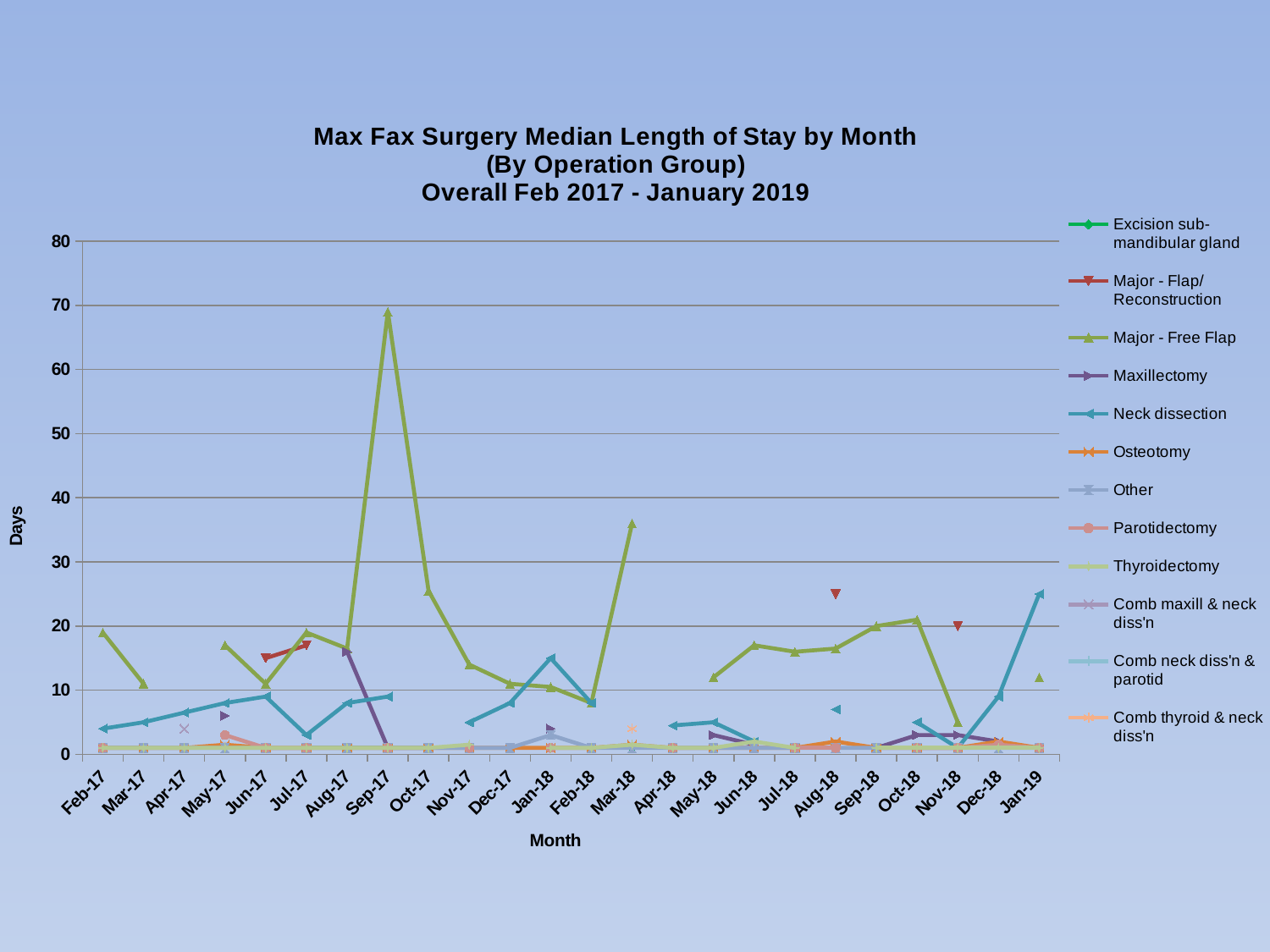
What kind of chart is shown on the slide? line chart What is the label of the x axis? Month Which is larger for Major - Free Flap: the value in Sep-17 or the value in Oct-17? Sep-17 Is the value for Neck dissection in Jul-17 greater or less than 10? less How many months are shown along the x axis? 24 Is the value for Major - Free Flap in Mar-18 greater or less than 30? greater Is the value for Major - Free Flap in Sep-17 greater or less than 60? greater Does the Major - Free Flap series rise or fall from Sep-17 to Feb-18? fall In which month does the Major - Free Flap series reach its highest value? Sep-17 How many series does the legend list? 12 What is the label of the y axis? Days